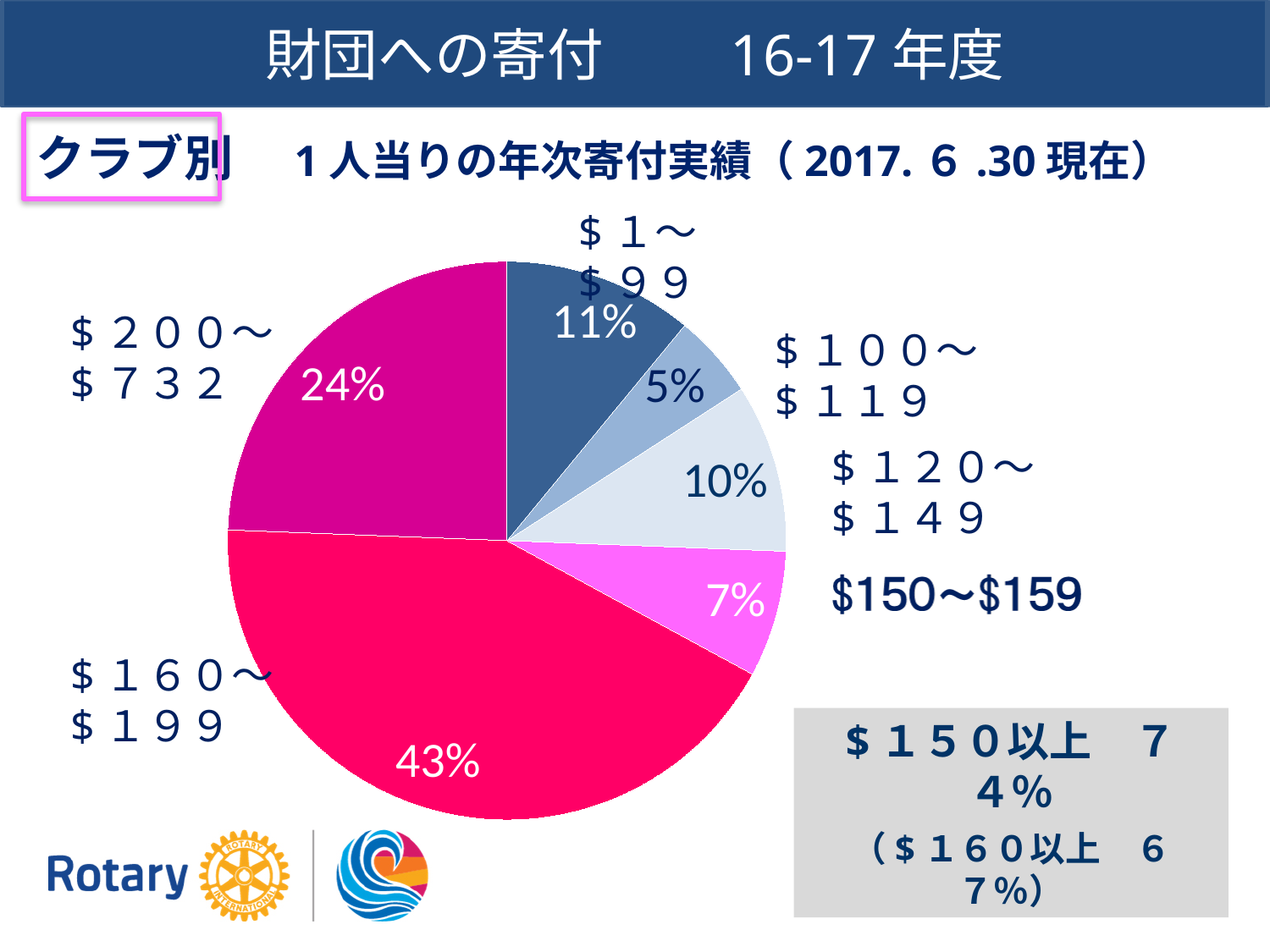
What is the difference in percentage points between the $160〜$199 slice and the $200〜$732 slice? 19 How many slices does the pie chart have? 6 What share of the pie is the $1〜$99 slice? 11% What share of the pie is the $200〜$732 slice? 24% Which category has the smallest share of the pie? $100〜$119 What share of the pie is the $160〜$199 slice? 43% Which category has the largest share of the pie? $160〜$199 Which slice is larger, $1〜$99 or $120〜$149? $1〜$99 What kind of chart is shown on the slide? pie chart